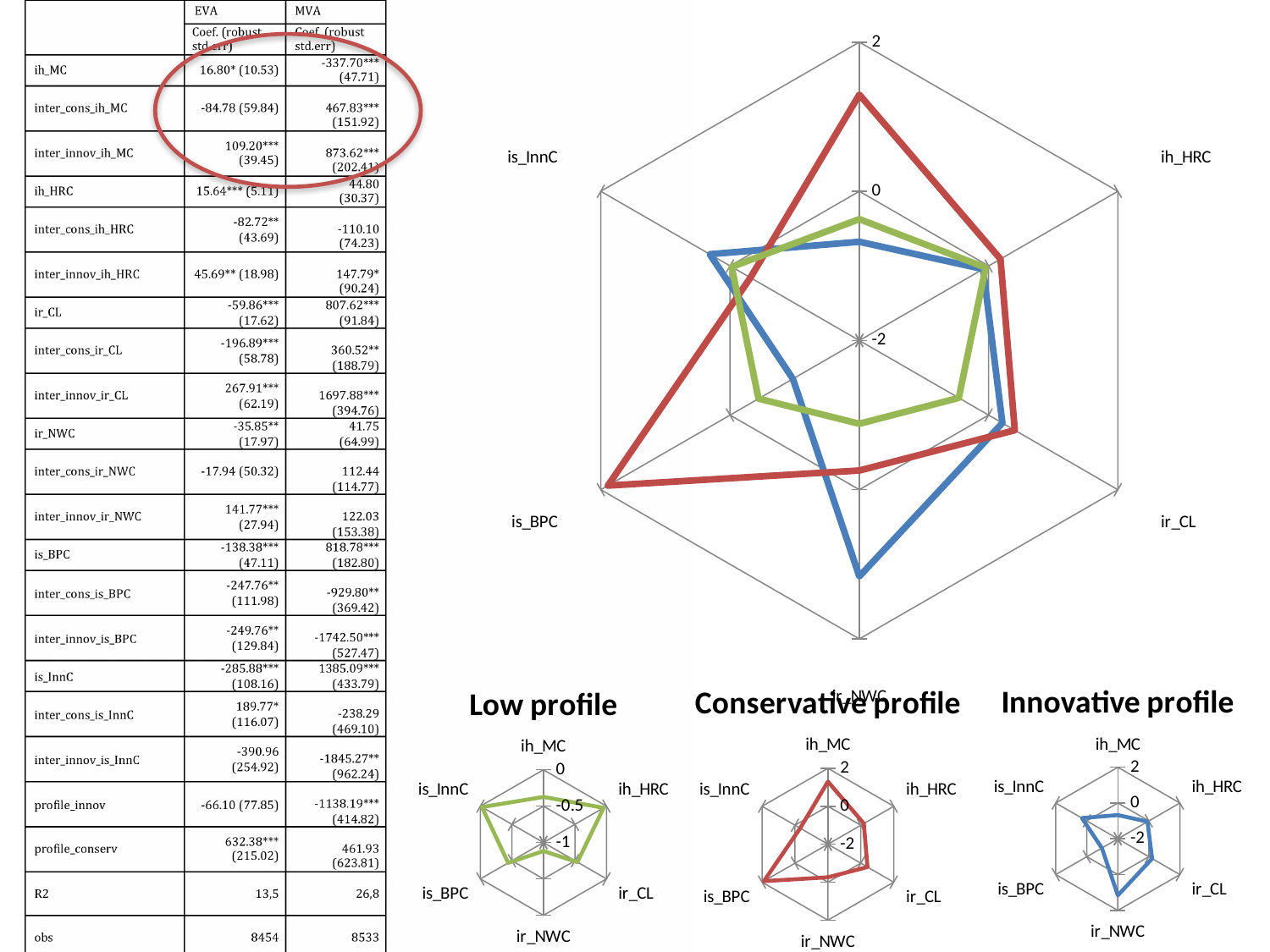
How many axes (categories) does the large radar chart have? 6 In the large radar chart, is the value of the red series for is_BPC greater or less than 0? greater In the large radar chart, is the value of the blue series for ir_NWC greater or less than 0? greater How many data series (lines) are plotted on the large radar chart? 3 In the large radar chart, is the value of the green series for is_BPC greater or less than 0? less What are the titles of the three small radar charts at the bottom of the slide? Low profile, Conservative profile, Innovative profile What kind of chart is the large chart at the top right of the slide? Radar chart What colour is the line in the Conservative profile chart? Red